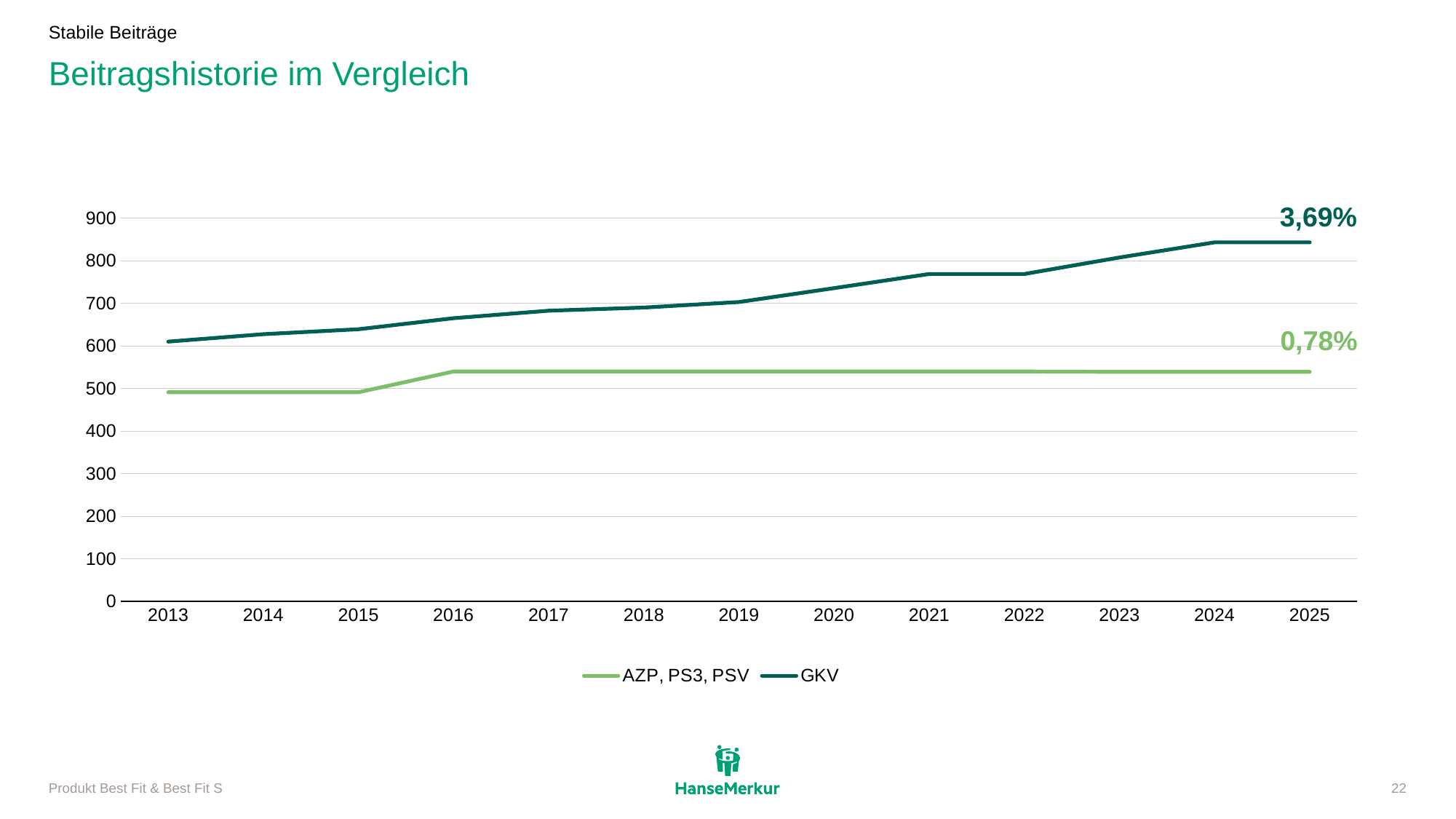
Is the GKV value for 2016 greater or less than 700? less In which year is the GKV value lowest? 2013 Is the value for AZP, PS3, PSV in 2025 greater or less than 500? greater How many series does the legend list? 2 What kind of chart is shown on the slide? line chart What percentage is printed next to the AZP, PS3, PSV line at the right of the chart? 0,78% Is the GKV value for 2025 greater or less than 800? greater What percentage is printed next to the GKV line at the right of the chart? 3,69% Which series has the higher value in 2025, AZP, PS3, PSV or GKV? GKV How many years are shown on the x axis? 13 Does the GKV line rise or fall from 2013 to 2025? rise